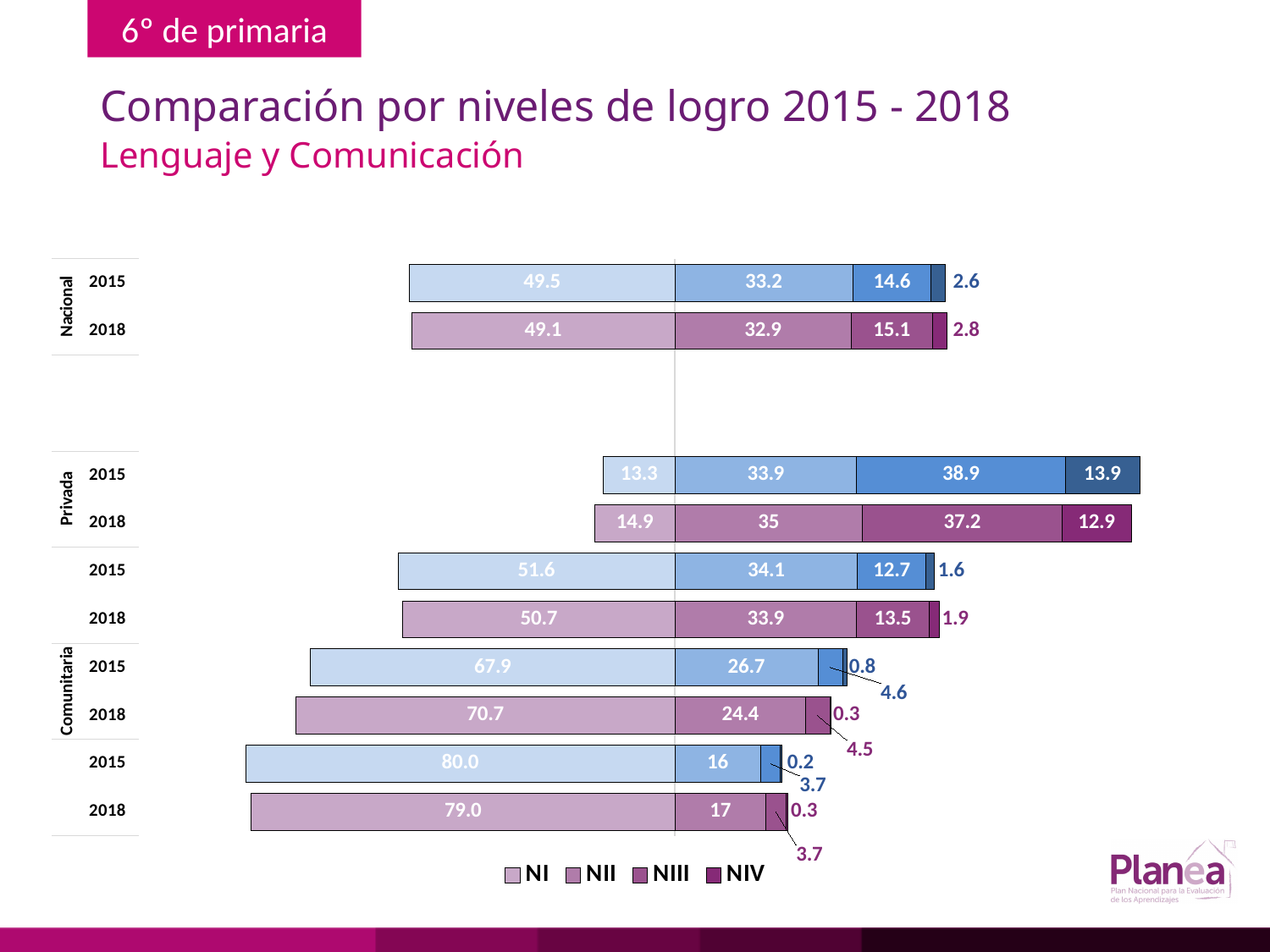
For Privada 2015, which is larger, the NII value or the NIII value? NIII Which year has the larger NI value for Privada, 2015 or 2018? 2018 What is the NIV value for the Privada 2015 bar? 13.9 What is the NI value for the bottom 2018 bar on the chart? 79.0 What is the difference between the NIII values for Nacional 2018 and Nacional 2015? 0.5 What is the NIII value for the Privada 2018 bar? 37.2 How many stacked bars are plotted on the chart? 10 What is the NII value for the Nacional 2018 bar? 32.9 How many series does the legend list? 4 What kind of chart is shown on the slide? Stacked bar chart What is the NI value for the Nacional 2015 bar? 49.5 What is the total of the Nacional 2015 stacked bar? 99.9